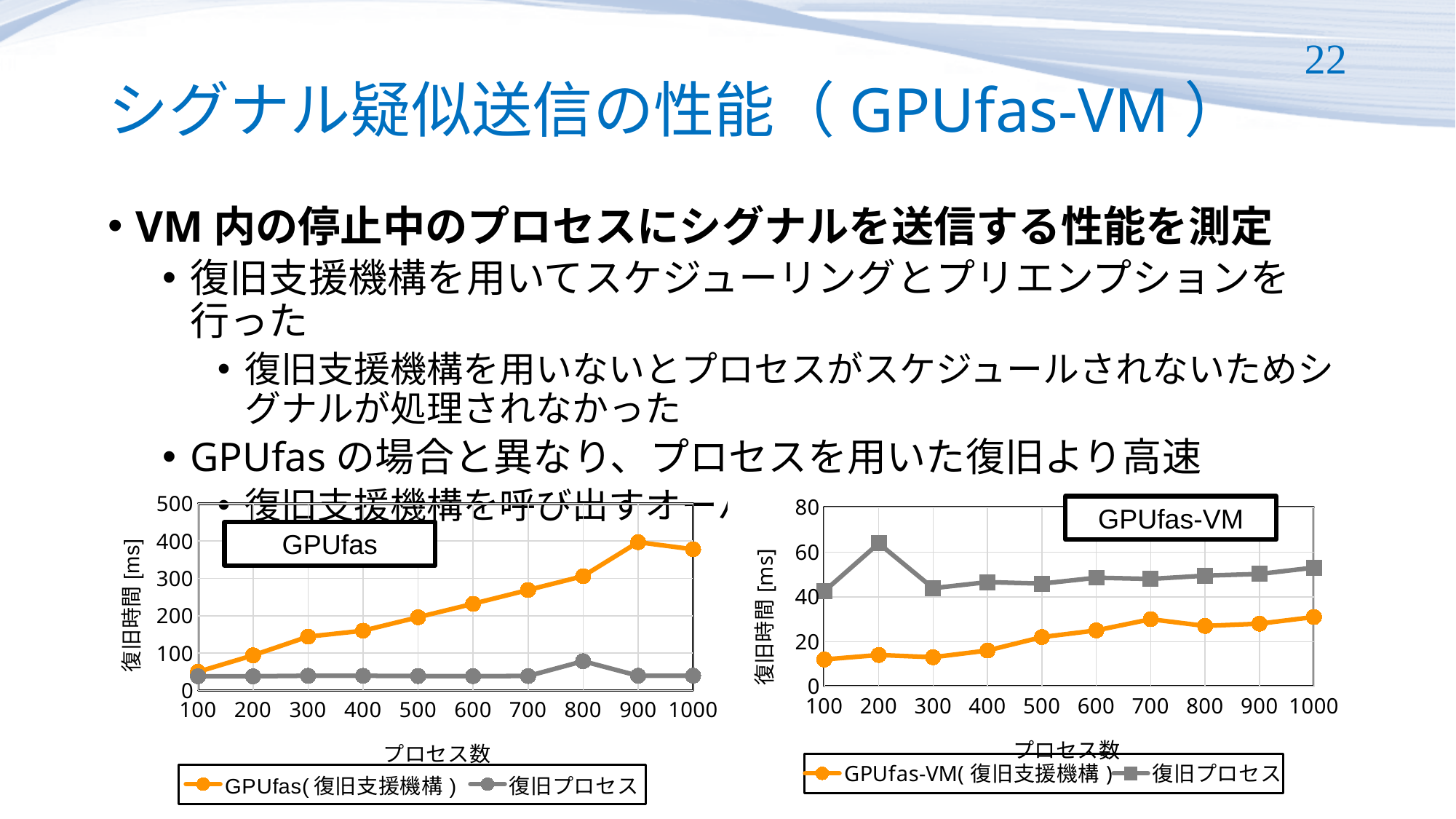
In the GPUfas-VM chart on the right, what is the label of the y axis? 復旧時間 [ms] In the GPUfas chart on the left, how many process-count points are plotted along the x axis? 10 In the GPUfas chart on the left, does the GPUfas(復旧支援機構) series generally rise or fall as the number of processes increases? rise In the GPUfas-VM chart on the right, how many series does the legend list? 2 In the GPUfas chart on the left, which series is larger at 700 processes, GPUfas(復旧支援機構) or 復旧プロセス? GPUfas(復旧支援機構) In the GPUfas chart on the left, is the value of GPUfas(復旧支援機構) at 1000 processes greater or less than 300? greater In the GPUfas-VM chart on the right, which series is larger at 600 processes, GPUfas-VM(復旧支援機構) or 復旧プロセス? 復旧プロセス In the GPUfas chart on the left, is the value of 復旧プロセス at 500 processes greater or less than 100? less In the GPUfas-VM chart on the right, at which number of processes does 復旧プロセス reach its highest value? 200 In the GPUfas chart on the left, at which number of processes does GPUfas(復旧支援機構) reach its highest value? 900 In the GPUfas chart on the left, what kind of chart is shown? line chart In the GPUfas-VM chart on the right, is the value of GPUfas-VM(復旧支援機構) at 100 processes greater or less than 20? less